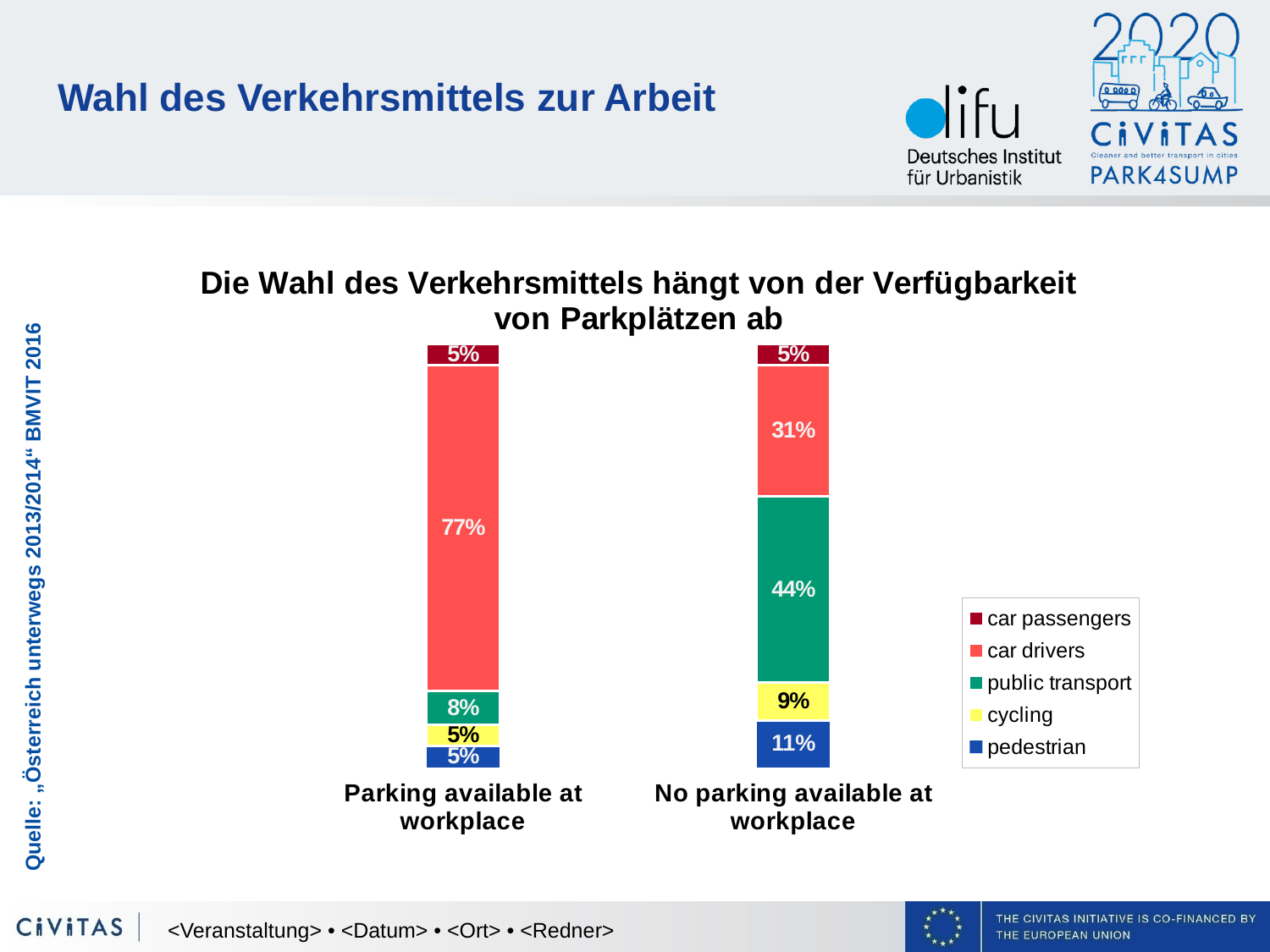
How many categories (bars) does the chart show? 2 What is the difference in the car drivers share between "Parking available at workplace" and "No parking available at workplace"? 46% How many series does the legend list? 5 What share of car drivers is shown for "Parking available at workplace"? 77% What is the total of the "No parking available at workplace" stacked bar? 100% What type of chart is shown on the slide? stacked bar chart What is the pedestrian share for "No parking available at workplace"? 11% Which mode has the largest share in the "No parking available at workplace" bar? public transport What is the cycling share for "Parking available at workplace"? 5% What share of public transport is shown for "No parking available at workplace"? 44% Which mode has the largest share in the "Parking available at workplace" bar? car drivers Is the public transport share larger for "Parking available at workplace" or "No parking available at workplace"? No parking available at workplace